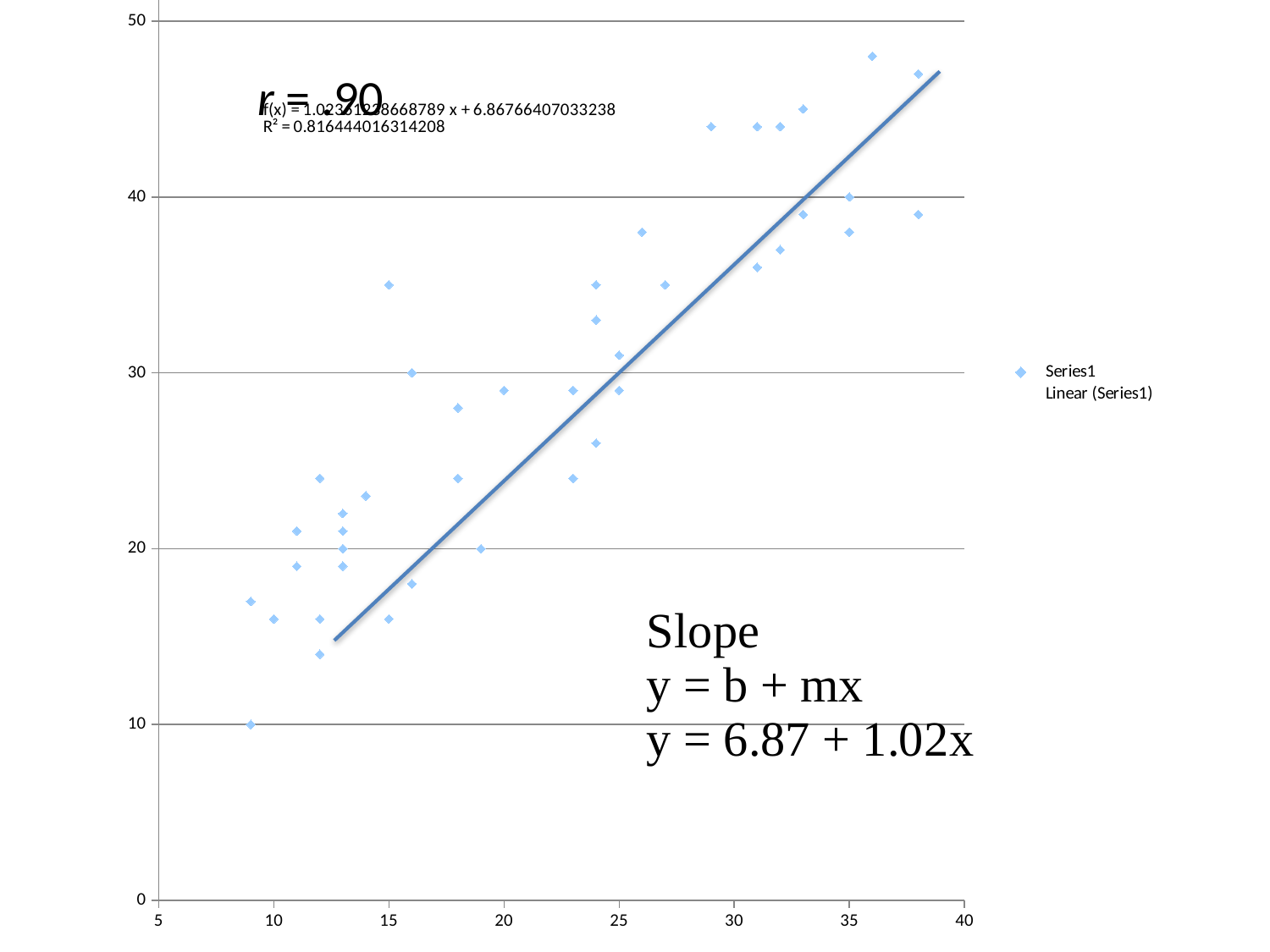
Is the y value of the highest data point greater or less than 45? greater How many entries does the legend list? 2 Do the plotted values generally rise or fall as x increases? rise What kind of chart is shown on the slide? scatter plot What are the two entries listed in the legend? Series1 and Linear (Series1) What R² value is printed on the chart? 0.816444016314208 Is the trendline's value at x = 15 greater or less than 20? greater Is the trendline's value at x = 35 greater or less than 40? greater